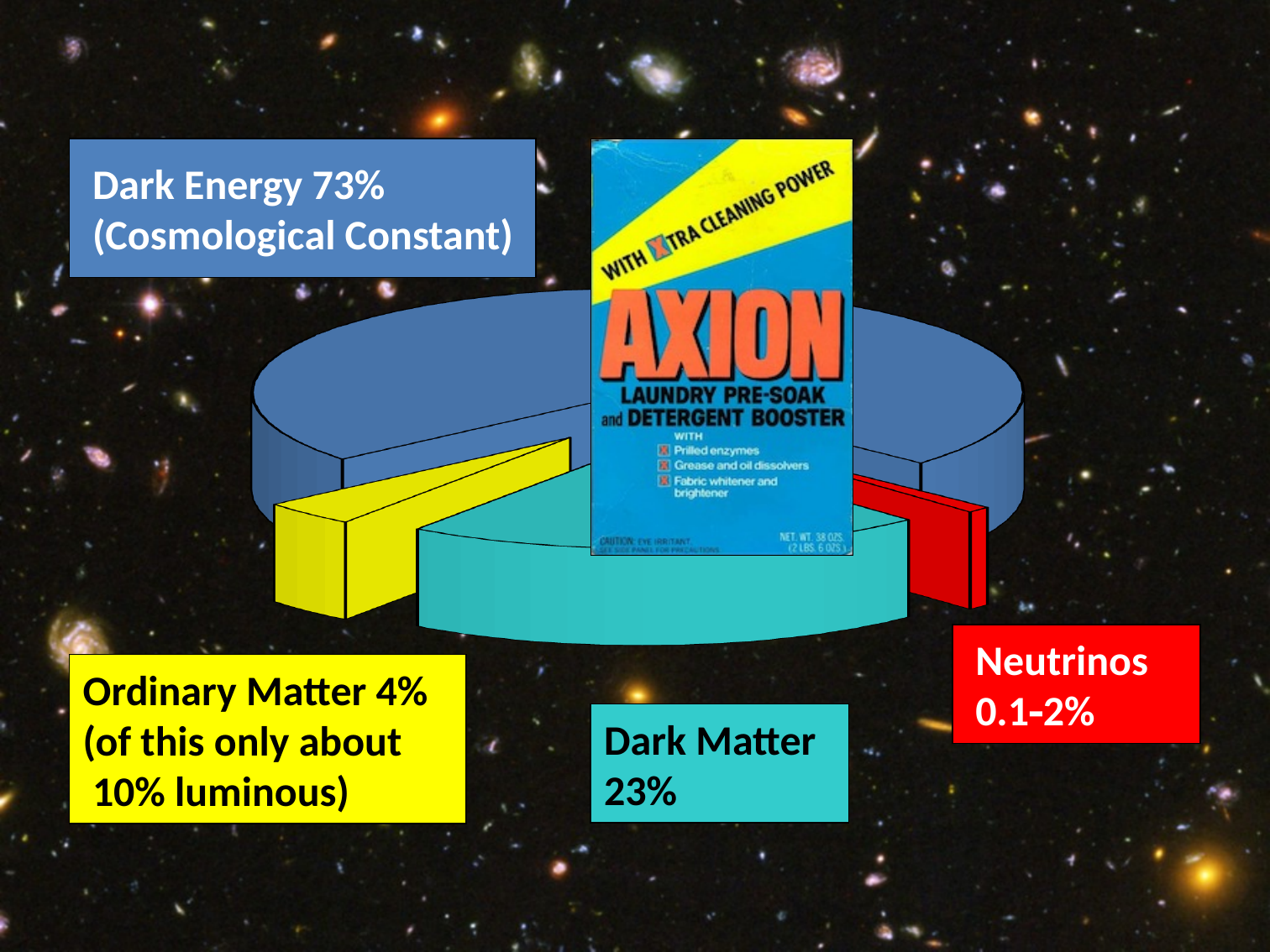
What percentage is labelled for Dark Matter? 23% What colour is the Ordinary Matter slice? yellow What colour is the Neutrinos slice? red What percentage is labelled for Dark Energy? 73% Which is larger, the Dark Matter slice or the Ordinary Matter slice? Dark Matter Which component has the smallest slice of the pie? Neutrinos How many slices does the pie chart have? 4 By how many percentage points does Dark Energy exceed Dark Matter? 50 What range is labelled for Neutrinos? 0.1-2% Which component has the largest slice of the pie? Dark Energy What percentage is labelled for Ordinary Matter? 4% What kind of chart is shown on the slide? pie chart